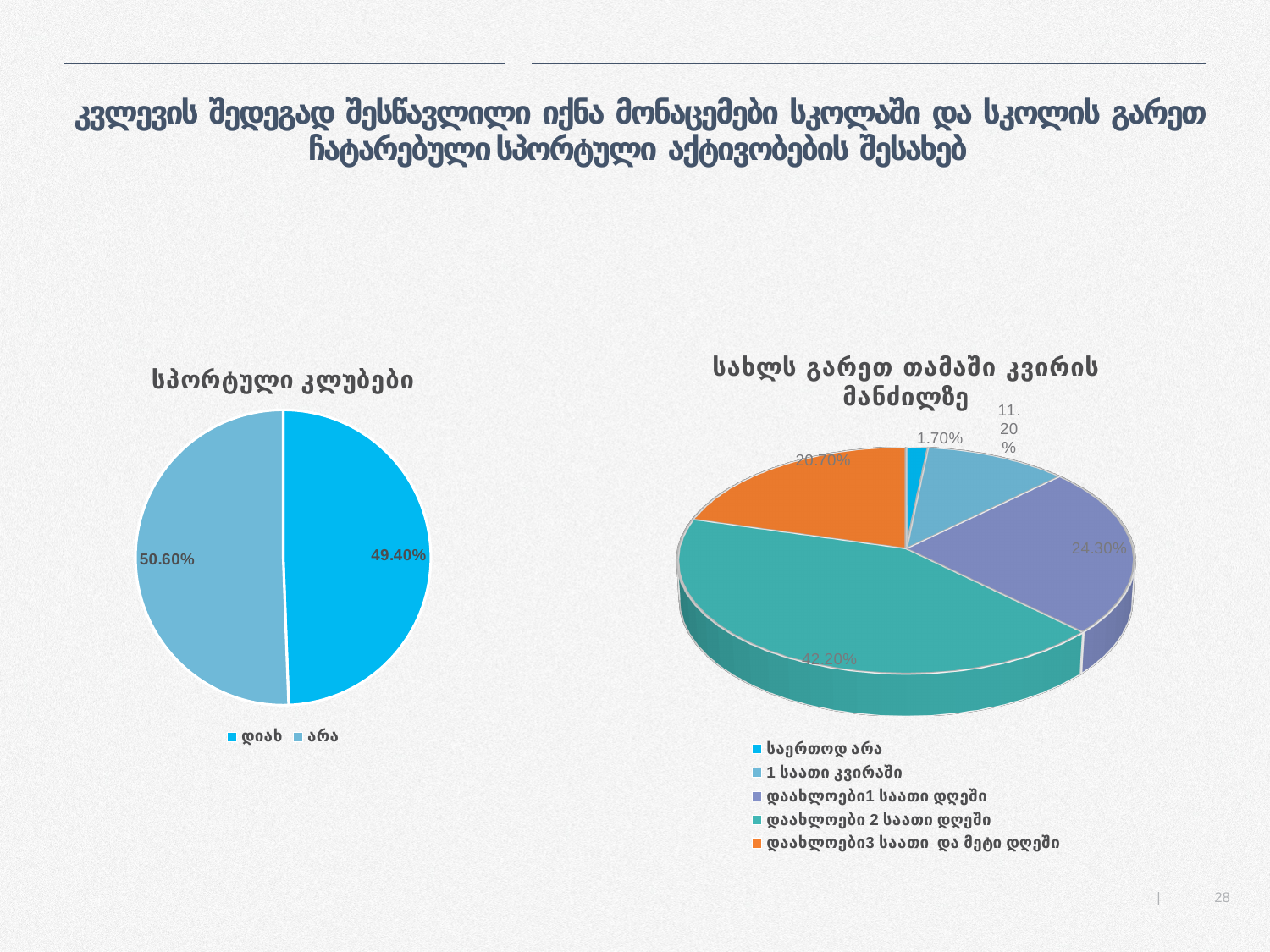
In the left chart "სპორტული კლუბები", what is the value for "არა"? 50.60% In the right chart "სახლს გარეთ თამაში კვირის მანძილზე", which category has the largest slice? დაახლოები 2 საათი დღეში How many entries does the legend of the left chart "სპორტული კლუბები" list? 2 In the left chart "სპორტული კლუბები", what is the difference between the "არა" and "დიახ" slices? 1.20% In the right chart "სახლს გარეთ თამაში კვირის მანძილზე", what is the difference between "დაახლოები1 საათი დღეში" and "1 საათი კვირაში"? 13.10% In the left chart "სპორტული კლუბები", what is the value for "დიახ"? 49.40% In the right chart "სახლს გარეთ თამაში კვირის მანძილზე", what is the value for "საერთოდ არა"? 1.70% In the right chart "სახლს გარეთ თამაში კვირის მანძილზე", which category has the smallest slice? საერთოდ არა What kind of chart is the left chart titled "სპორტული კლუბები"? pie chart How many categories does the legend of the right chart "სახლს გარეთ თამაში კვირის მანძილზე" list? 5 In the left chart "სპორტული კლუბები", which slice is larger, "დიახ" or "არა"? არა In the right chart "სახლს გარეთ თამაში კვირის მანძილზე", what is the value for "დაახლოები 2 საათი დღეში"? 42.20%